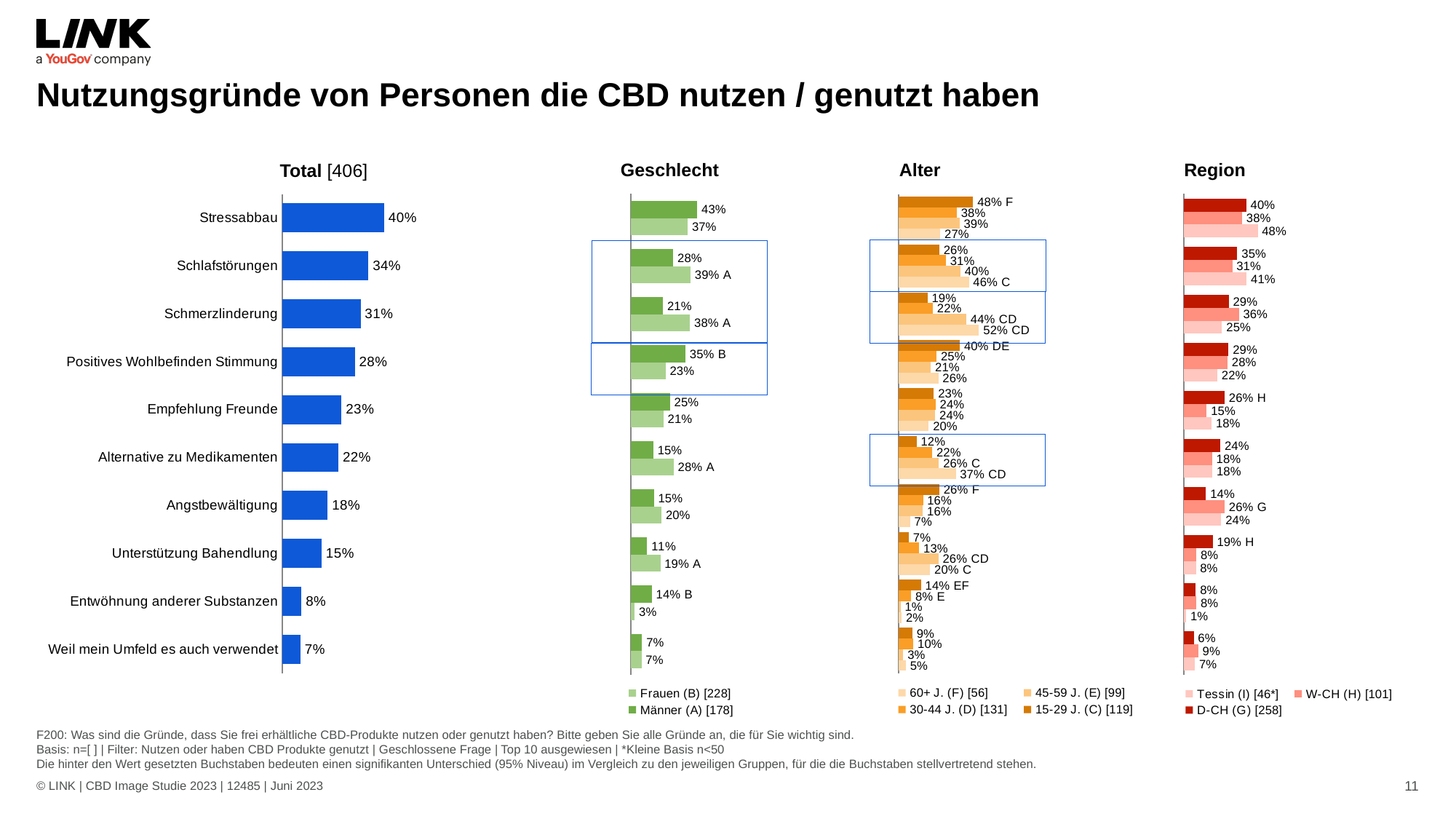
How many categories are shown in the Total chart? 10 In the Region chart, what is the difference between D-CH and W-CH for Unterstützung Bahendlung? 11% In the Alter chart, what is the value for 15-29 J. for Stressabbau? 48% How many series does the legend of the Alter chart list? 4 In the Geschlecht chart, which is larger for Positives Wohlbefinden Stimmung, Männer or Frauen? Männer In the Total chart, what is the value for Stressabbau? 40% What kind of chart is the Total chart? bar chart In the Total chart, what is the difference between Schlafstörungen and Schmerzlinderung? 3% How many series does the legend of the Geschlecht chart list? 2 In the Region chart, what is the value for Tessin for Stressabbau? 48% In the Total chart, which category has the lowest value? Weil mein Umfeld es auch verwendet In the Geschlecht chart, what is the value for Frauen for Schlafstörungen? 39%